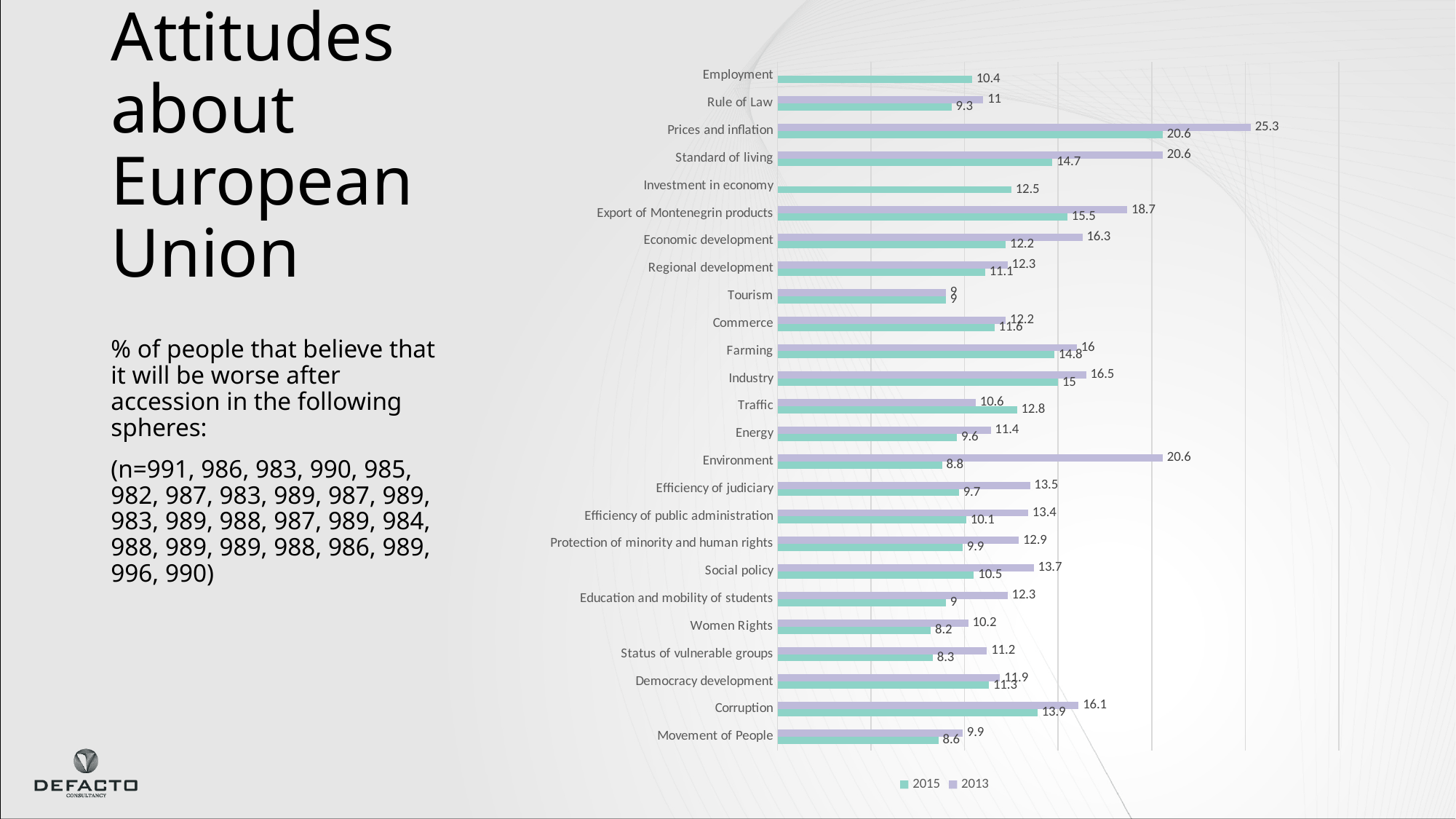
What is the 2013 value for Prices and inflation? 25.3 How many series does the legend list? 2 What is the difference between the 2013 and 2015 values for Standard of living? 5.9 Which is larger, the 2015 value for Industry or the 2015 value for Farming? Industry Which category has the lowest 2015 value? Women Rights Which is larger for Traffic, the 2013 value or the 2015 value? 2015 What is the 2015 value for Environment? 8.8 Which category has the highest 2013 value? Prices and inflation How many categories are shown on the chart? 25 What kind of chart is shown on the slide? Bar chart What is the difference between the 2013 and 2015 values for Environment? 11.8 What is the 2015 value for Corruption? 13.9